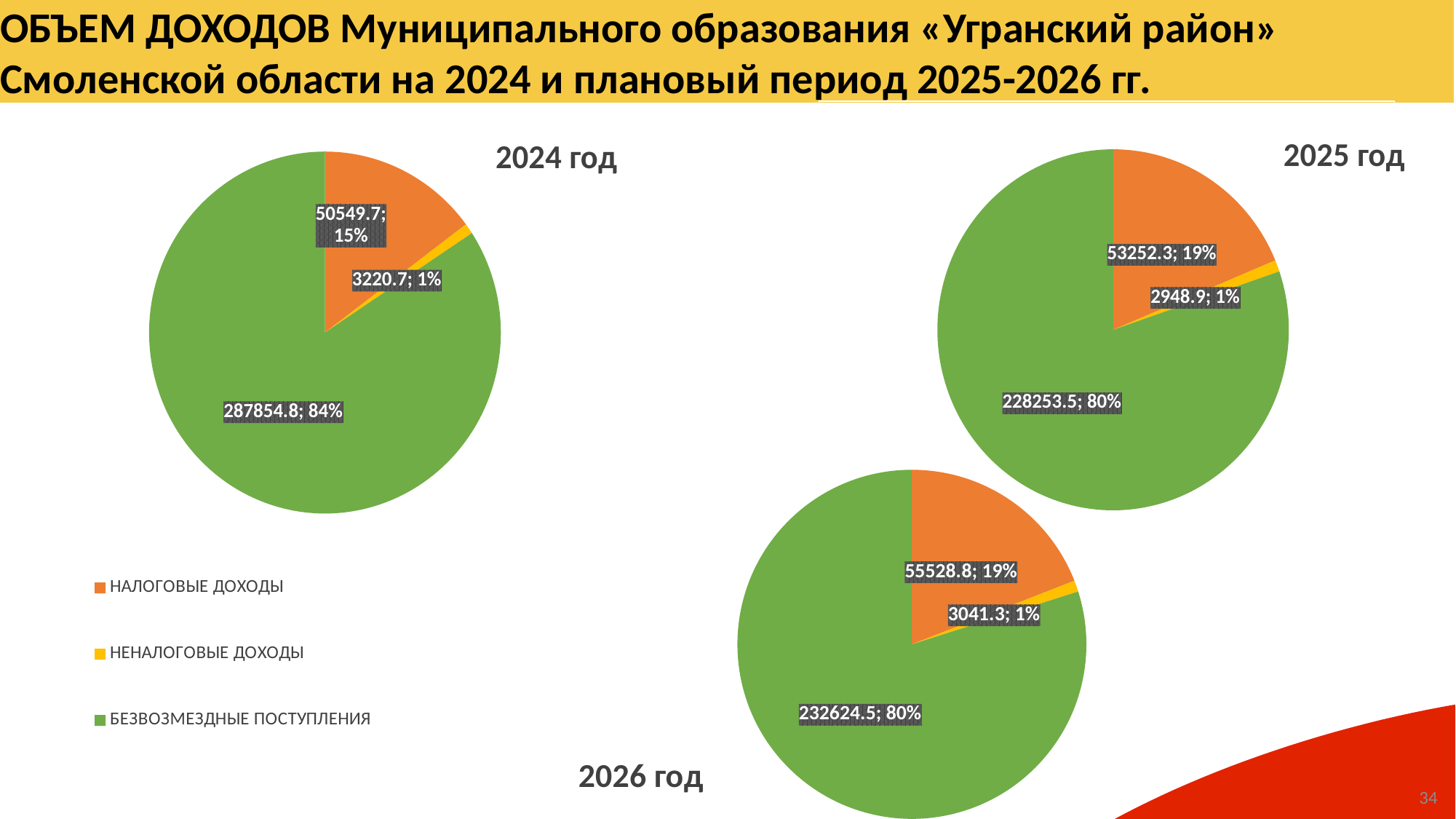
How many categories does the legend list? 3 Which is larger: НАЛОГОВЫЕ ДОХОДЫ in the 2024 год chart or НАЛОГОВЫЕ ДОХОДЫ in the 2026 год chart? 2026 год In the 2025 год chart, which category has the largest slice? БЕЗВОЗМЕЗДНЫЕ ПОСТУПЛЕНИЯ In the 2025 год chart, what is the value for НЕНАЛОГОВЫЕ ДОХОДЫ? 2948.9 In the 2026 год chart, what is the difference between the values for НАЛОГОВЫЕ ДОХОДЫ and НЕНАЛОГОВЫЕ ДОХОДЫ? 52487.5 In the 2026 год chart, what is the value for БЕЗВОЗМЕЗДНЫЕ ПОСТУПЛЕНИЯ? 232624.5 In the 2024 год chart, what share of the pie is БЕЗВОЗМЕЗДНЫЕ ПОСТУПЛЕНИЯ? 84% What type of chart is used for the 2024 год chart? pie chart In the 2024 год chart, what is the value for НАЛОГОВЫЕ ДОХОДЫ? 50549.7 In the 2026 год chart, which category has the smallest slice? НЕНАЛОГОВЫЕ ДОХОДЫ Which colour represents НЕНАЛОГОВЫЕ ДОХОДЫ in the legend? yellow In the 2025 год chart, what share of the pie is НАЛОГОВЫЕ ДОХОДЫ? 19%